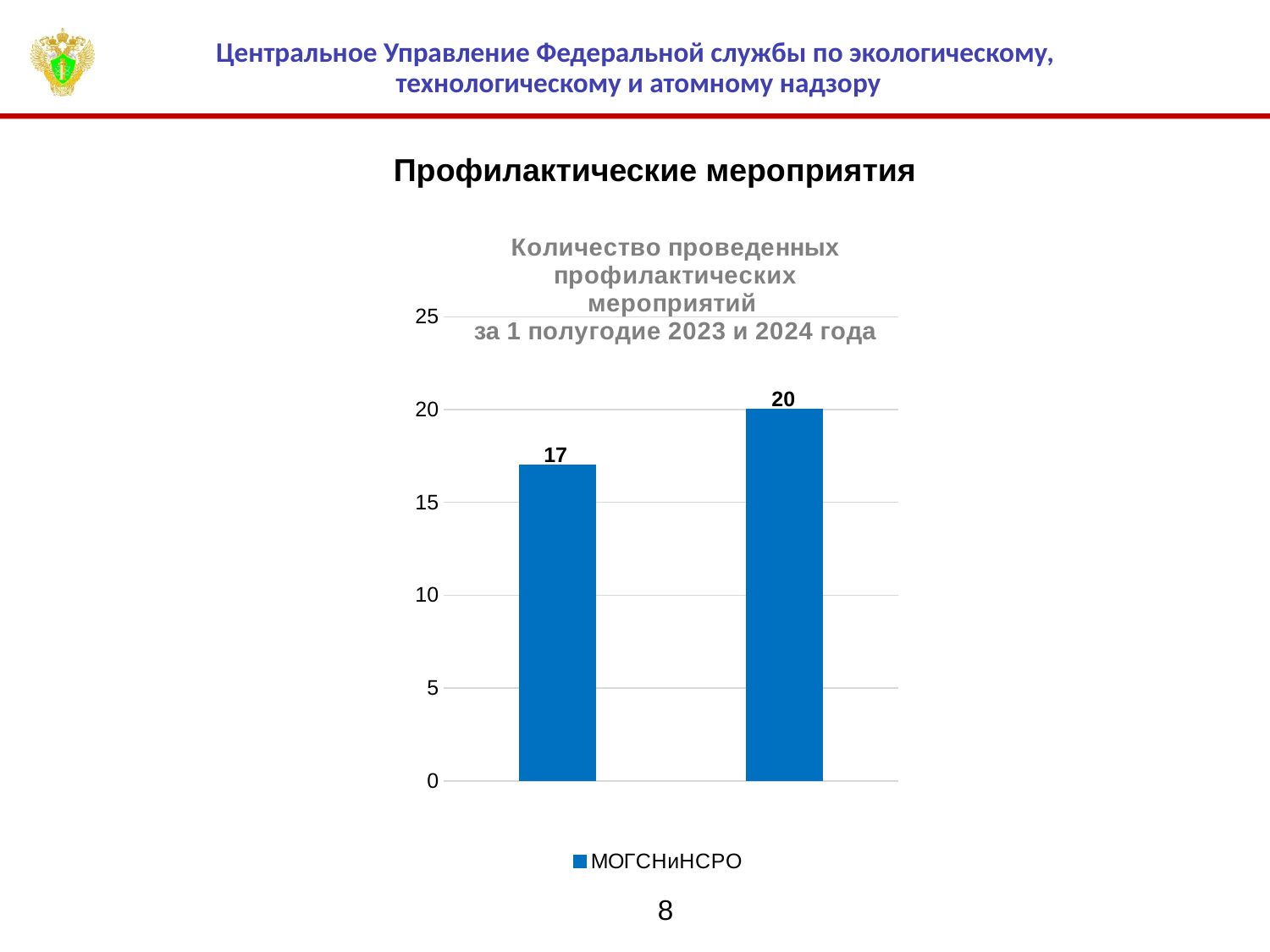
What is the value shown on the left bar of the chart? 17 What is the difference between the right bar's value and the left bar's value? 3 How many series does the chart legend list? 1 What series name is shown in the chart legend? МОГСНиНСРО How many bars are plotted in the chart? 2 What is the value shown on the right bar of the chart? 20 Is the value of the left bar greater or less than 15? greater What type of chart is shown on the slide? bar chart Which bar is taller, the left bar or the right bar? the right bar Is the value of the right bar greater or less than 25? less What is the highest value plotted in the chart? 20 What is the lowest value plotted in the chart? 17